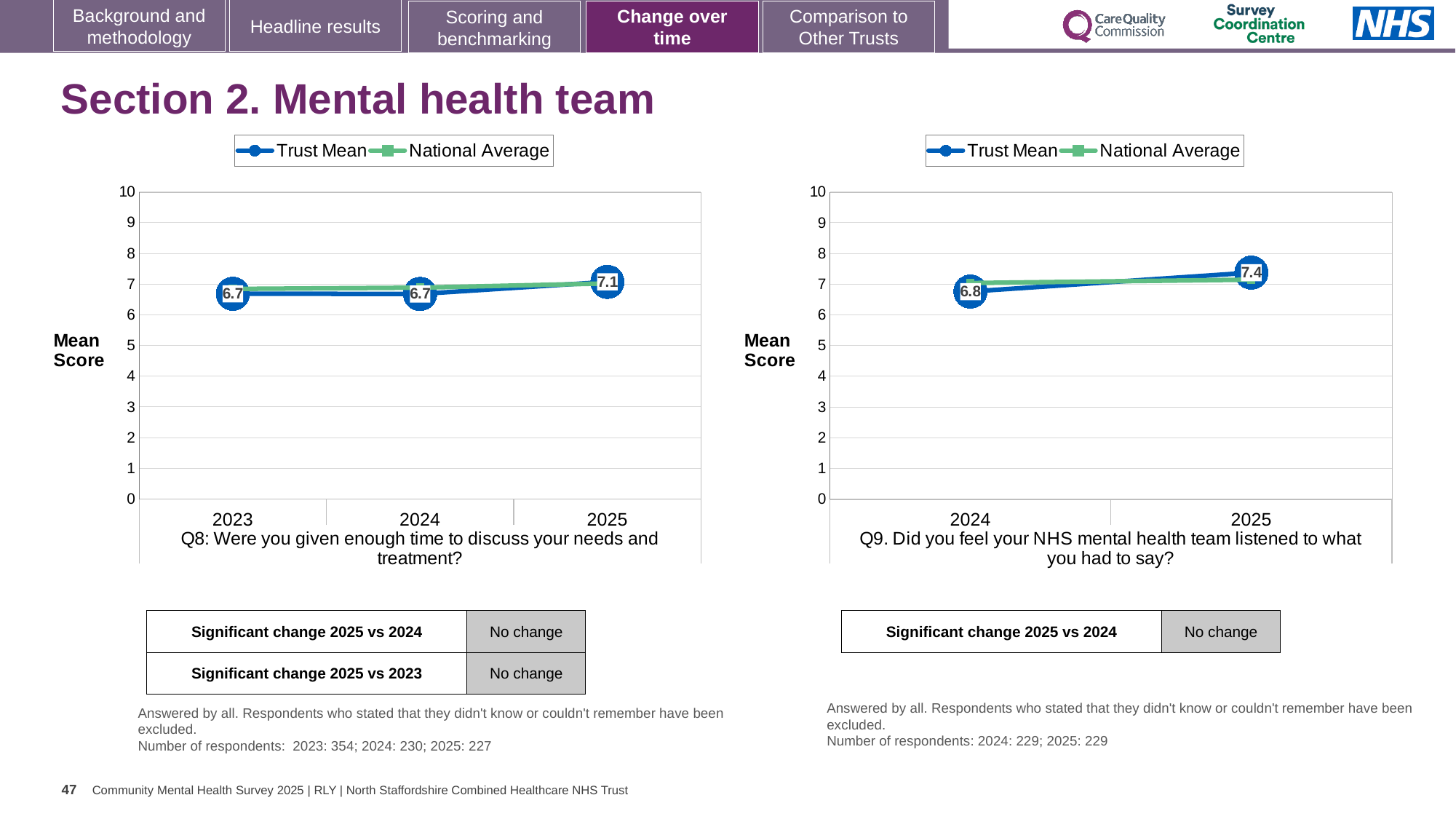
In the Q8 chart on the left, by how much did the Trust Mean change from 2024 to 2025? 0.4 In the Q8 chart on the left, which year has the highest Trust Mean? 2025 How many series does the legend of the Q9 chart on the right list? 2 In the Q8 chart on the left, what is the Trust Mean for 2025? 7.1 In the Q8 chart on the left, is the National Average for 2023 greater or less than 5? greater In the Q9 chart on the right, is the Trust Mean for 2025 larger or smaller than for 2024? larger In the Q9 chart on the right, what is the Trust Mean for 2024? 6.8 What kind of chart is the Q9 chart on the right? Line chart How many years are plotted in the Q8 chart on the left? 3 In the Q9 chart on the right, what is the Trust Mean for 2025? 7.4 In the Q9 chart on the right, what is the difference between the Trust Mean for 2025 and 2024? 0.6 In the Q8 chart on the left, what is the Trust Mean for 2023? 6.7